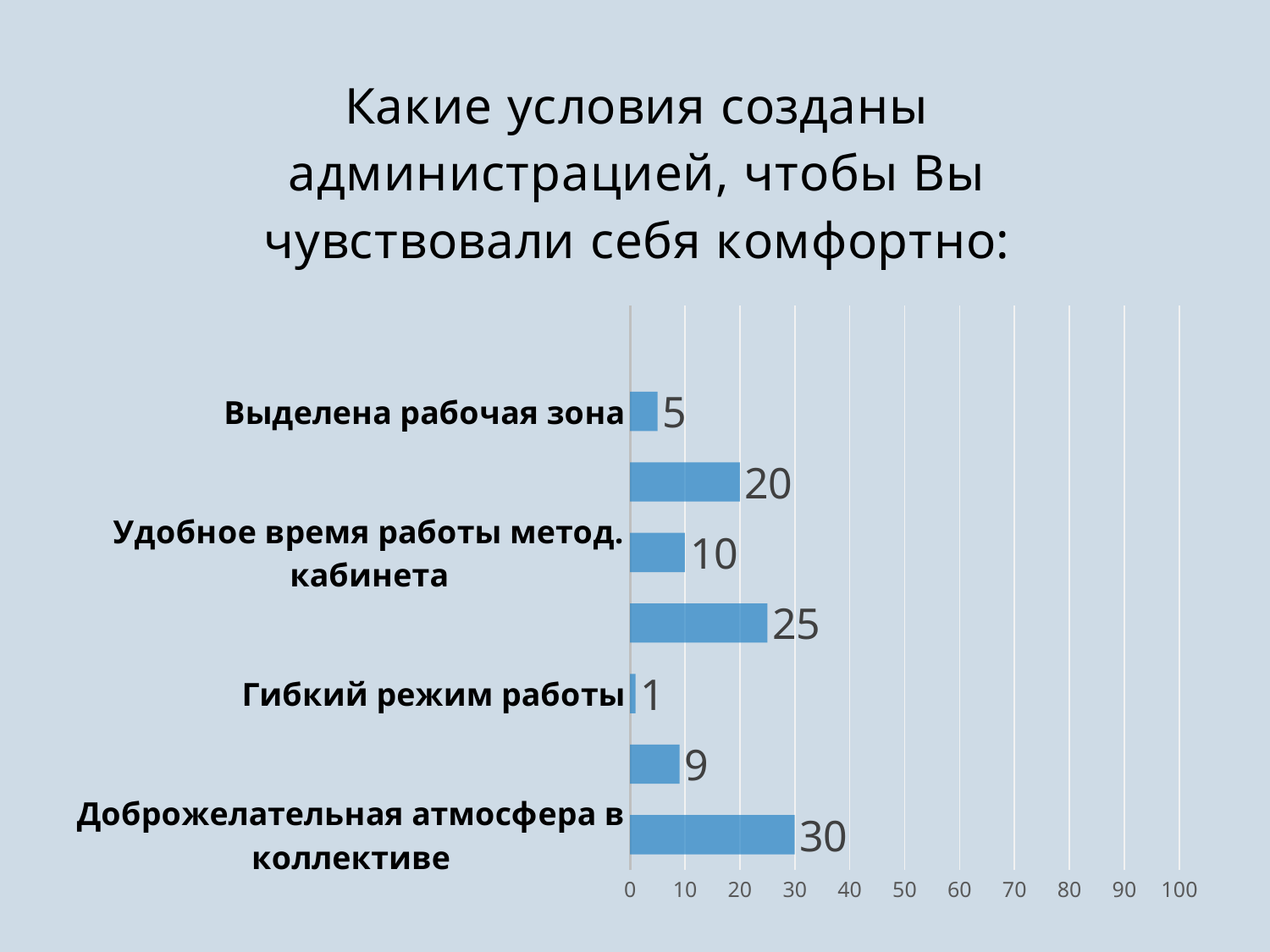
What is the difference between the values for "Доброжелательная атмосфера в коллективе" and "Выделена рабочая зона"? 25 Which category has the lowest value? Гибкий режим работы What value is shown for "Доброжелательная атмосфера в коллективе"? 30 Which category has the highest value? Доброжелательная атмосфера в коллективе Is the value for "Доброжелательная атмосфера в коллективе" greater or less than 20? greater What value is shown for "Гибкий режим работы"? 1 How many bars are plotted in the chart? 7 What value is shown for "Удобное время работы метод. кабинета"? 10 What kind of chart is shown on the slide? bar chart What is the highest value shown on the horizontal axis? 100 What value is shown for "Выделена рабочая зона"? 5 Which is larger: the value for "Удобное время работы метод. кабинета" or the value for "Выделена рабочая зона"? Удобное время работы метод. кабинета